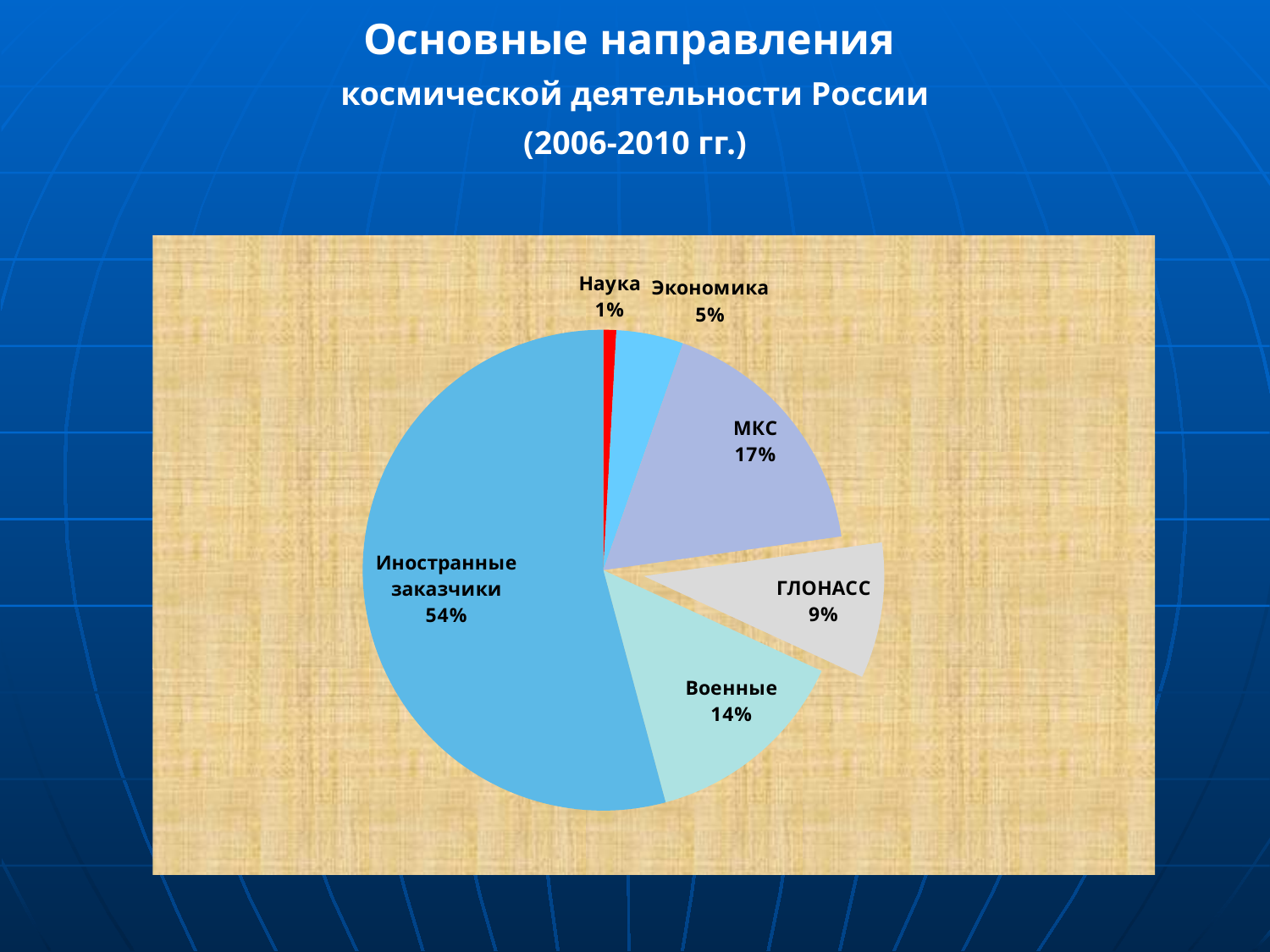
Which category has the largest slice of the pie? Иностранные заказчики What is the difference between the shares of МКС and Военные? 3% What is the combined share of Наука and Экономика? 6% Which category has the smallest slice of the pie? Наука What kind of chart is shown on the slide? Pie chart How many categories are shown in the pie chart? 6 What share of the pie does Иностранные заказчики have? 54% What is the value shown for Военные? 14% What is the value shown for МКС? 17% Which is larger, the share for Экономика or the share for ГЛОНАСС? ГЛОНАСС Which slice is pulled out (exploded) from the pie? ГЛОНАСС What is the value shown for ГЛОНАСС? 9%